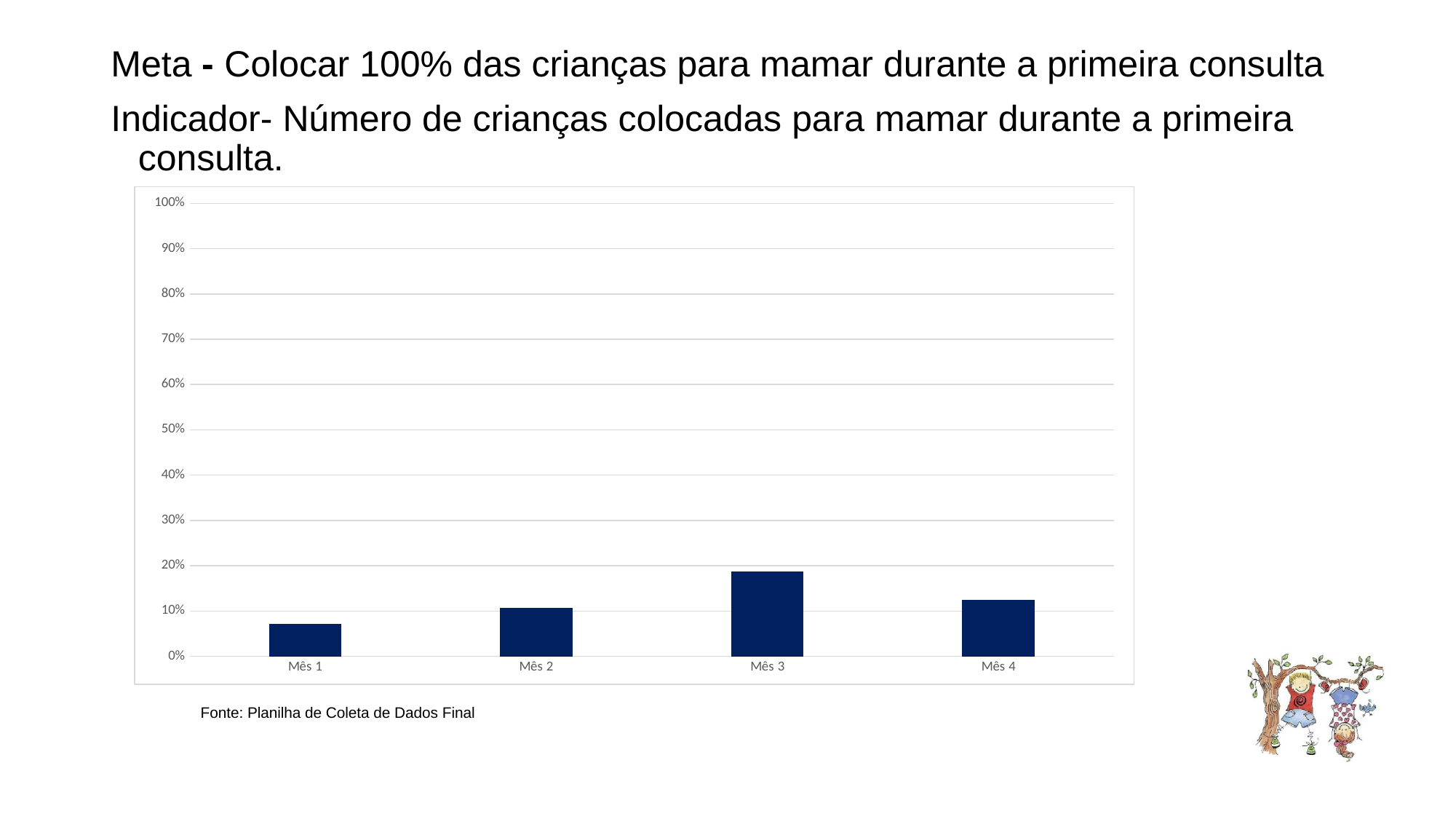
How many categories (months) are plotted on the x axis? 4 What is the maximum value shown on the vertical axis? 100% Which is larger, the value for Mês 3 or the value for Mês 4? Mês 3 Which month has the highest bar? Mês 3 Which is larger, the value for Mês 1 or the value for Mês 4? Mês 4 Do the values rise or fall from Mês 1 to Mês 3? rise Is the value for Mês 3 greater or less than 10%? greater Which month has the lowest bar? Mês 1 What kind of chart is shown on the slide? bar chart Is the value for Mês 4 greater or less than 20%? less Is the value for Mês 1 greater or less than 10%? less